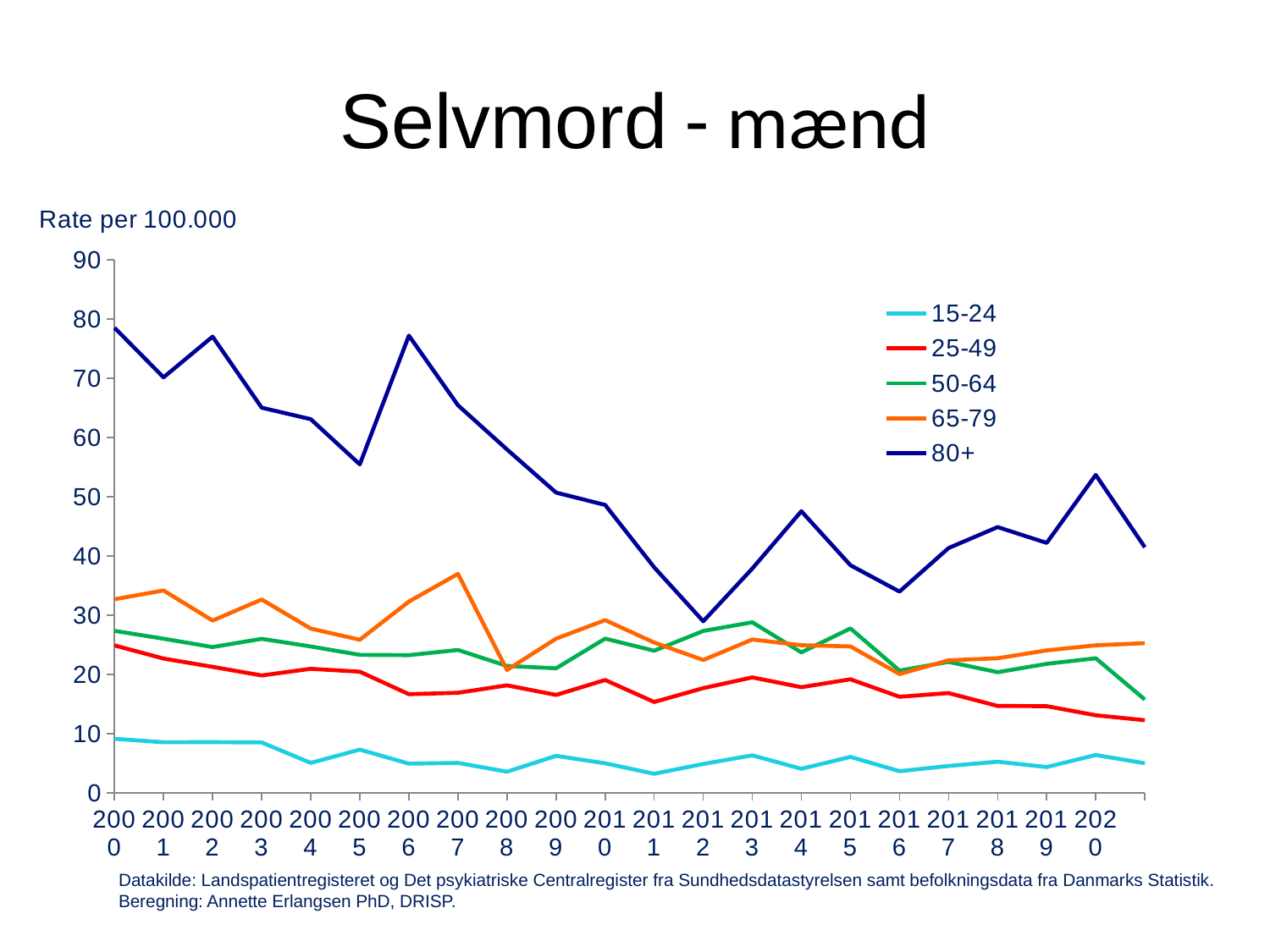
In which year is the 80+ rate at its lowest? 2012 Which age group has the highest rate across the whole period? 80+ In 2007, which is larger: the rate for 65-79 or the rate for 50-64? 65-79 Is the value for 80+ in 2000 greater or less than 70? greater What is the title of the slide's chart? Selvmord - mænd In which year is the 65-79 rate at its highest? 2007 What kind of chart is shown on the slide? line chart How many series does the legend list? 5 Does the 80+ rate generally rise or fall from 2000 to 2012? fall Which age group has the lowest rate across the whole period? 15-24 What unit label is shown above the y axis? Rate per 100.000